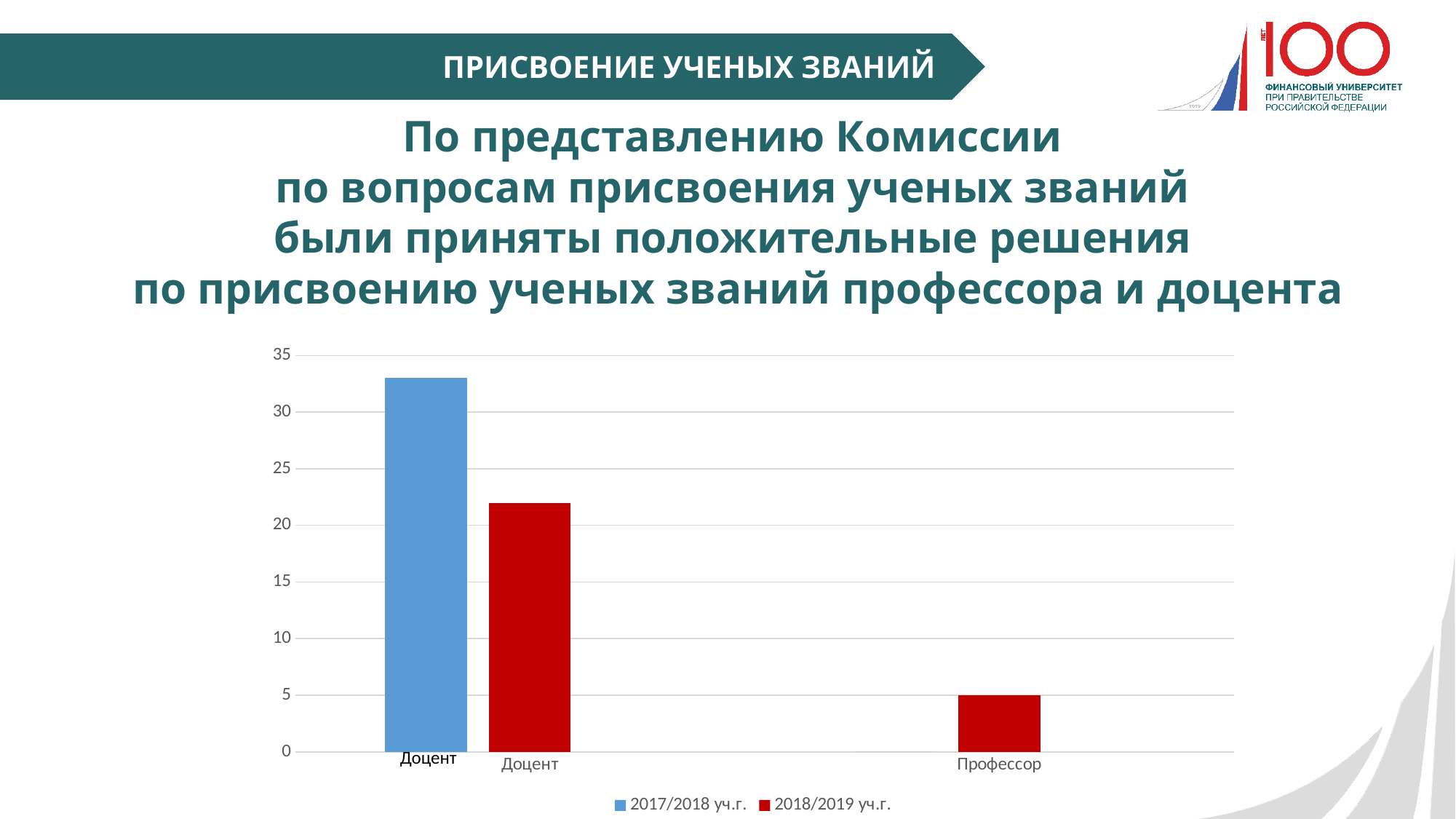
How many categories are shown on the x axis of the chart? 2 What kind of chart is shown on the slide? bar chart Is the value for Доцент in the 2017/2018 уч.г. series greater or less than 30? greater Which bar in the chart is the tallest? Доцент, 2017/2018 уч.г. What is the value for Профессор in the 2018/2019 уч.г. series? 5 Is the value for Доцент in the 2018/2019 уч.г. series greater or less than 20? greater Which is larger for Доцент: the 2017/2018 уч.г. value or the 2018/2019 уч.г. value? 2017/2018 уч.г. Is the value for Доцент in the 2018/2019 уч.г. series greater or less than 25? less What are the two series listed in the chart legend? 2017/2018 уч.г. and 2018/2019 уч.г. How many series does the chart legend list? 2 Which colour represents the 2018/2019 уч.г. series in the chart? red In the 2018/2019 уч.г. series, which category has the higher value, Доцент or Профессор? Доцент